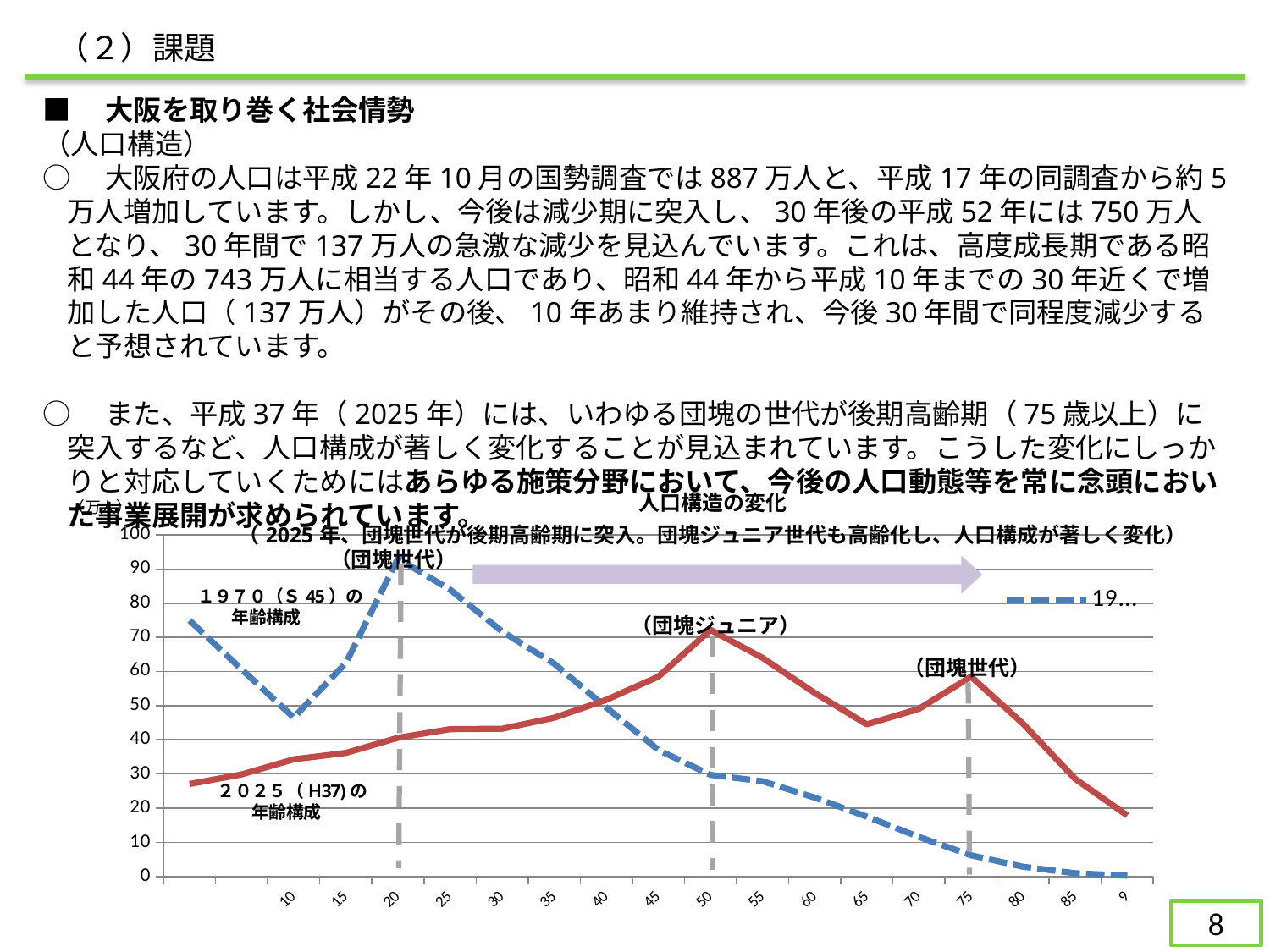
Is the value of the 1970 (S45) series at age 20 greater or less than 80? greater What kind of chart is shown on the slide? line chart What is the title of the chart? 人口構造の変化 Is the value of the 2025 (H37) series at age 75 greater or less than 50? greater Is the value of the 1970 (S45) series at age 85 greater or less than 10? less How many data series (lines) are plotted in the chart? 2 At age 20, which series has the higher value, 1970 (S45) or 2025 (H37)? 1970 (S45) At age 50, which series has the higher value, 1970 (S45) or 2025 (H37)? 2025 (H37) Does the 1970 (S45) series rise or fall from age 20 to age 90? fall Which series is drawn as a dashed line, the 1970 (S45) age composition or the 2025 (H37) age composition? 1970 (S45) の年齢構成